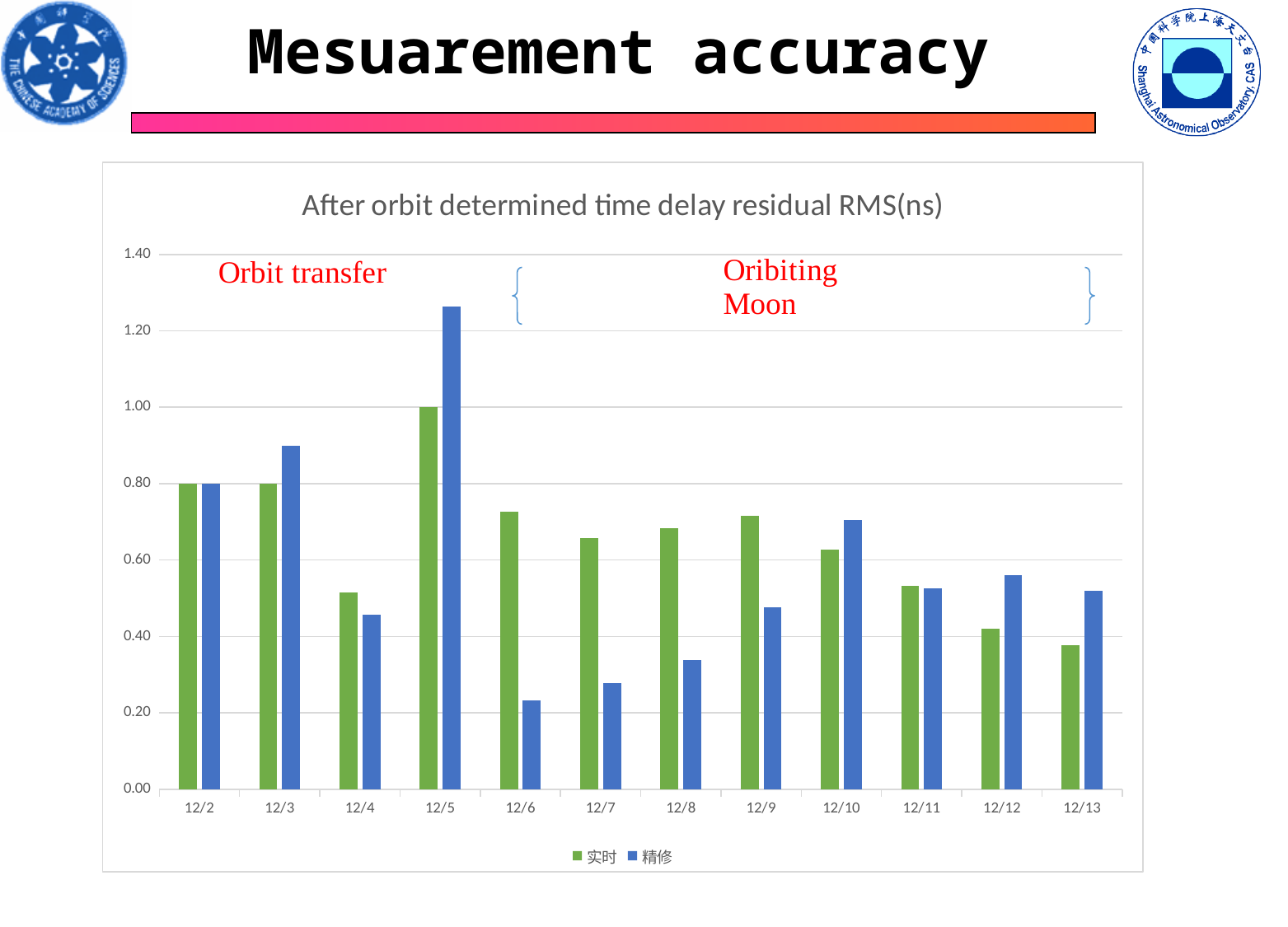
Is the 精修 value on 12/5 greater or less than 1.20? greater How many series does the legend list? 2 On which date is the 精修 value lowest? 12/6 On which date is the 实时 value highest? 12/5 On which date is the 精修 value highest? 12/5 On 12/7, which series has the larger value, 实时 or 精修? 实时 Is the 精修 value on 12/6 greater or less than 0.40? less What is the title of the chart? After orbit determined time delay residual RMS(ns) On 12/12, which series has the larger value, 实时 or 精修? 精修 How many dates are shown on the x axis of the chart? 12 What type of chart is shown on the slide? Bar chart What is the 实时 value on 12/5? 1.00